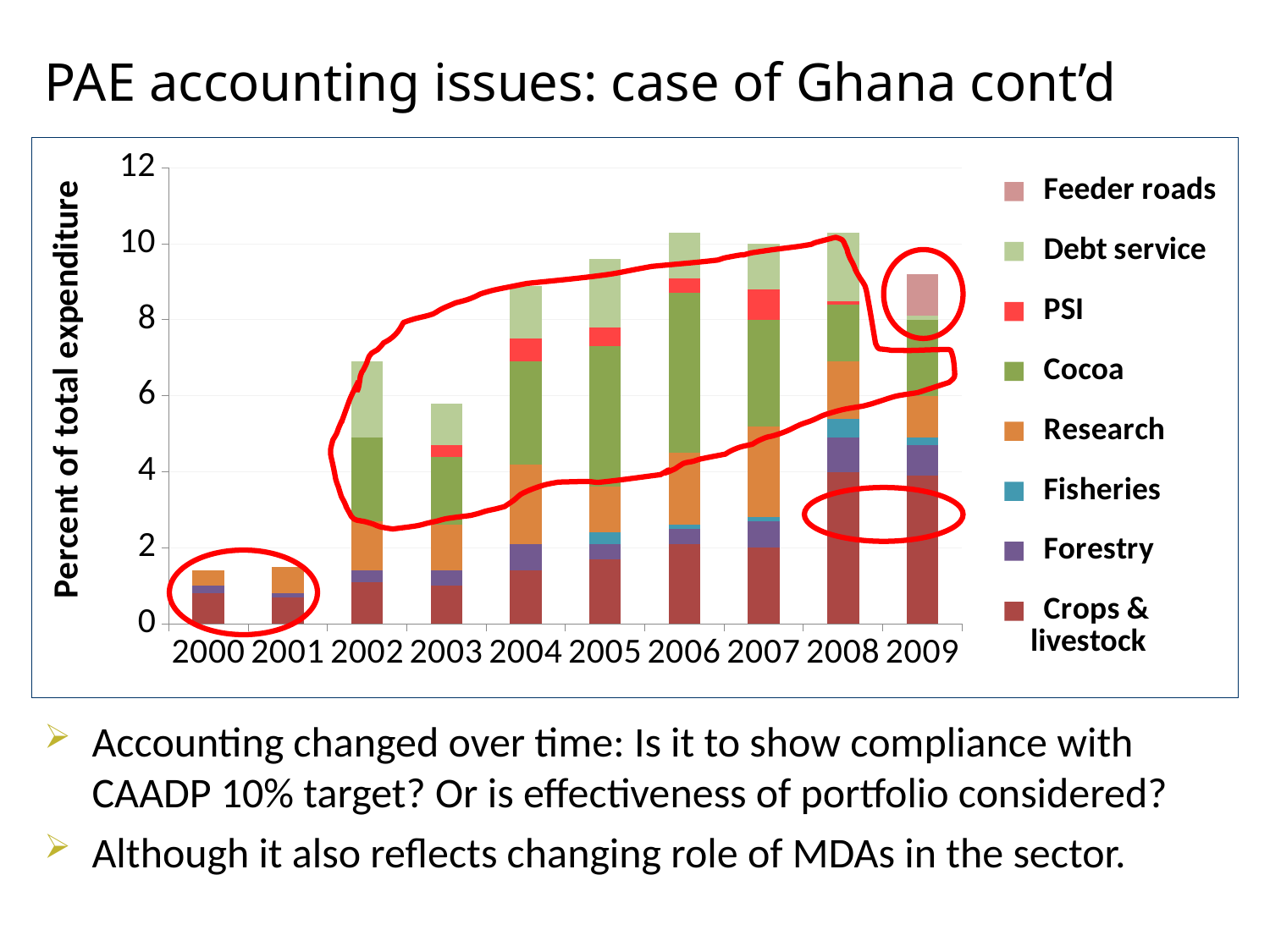
Is the total value of the bar for 2009 greater or less than 10? less Which year has the taller total bar, 2008 or 2009? 2008 What kind of chart is shown on the slide? Stacked bar chart What is the label on the vertical axis of the chart? Percent of total expenditure How many series does the chart's legend list? 8 Which colour represents Cocoa in the chart? Green Is the total value of the bar for 2004 greater or less than 8? greater Is the total value of the bar for 2006 greater or less than 10? greater Which year has the taller total bar, 2002 or 2003? 2002 How many years are shown along the x axis of the chart? 10